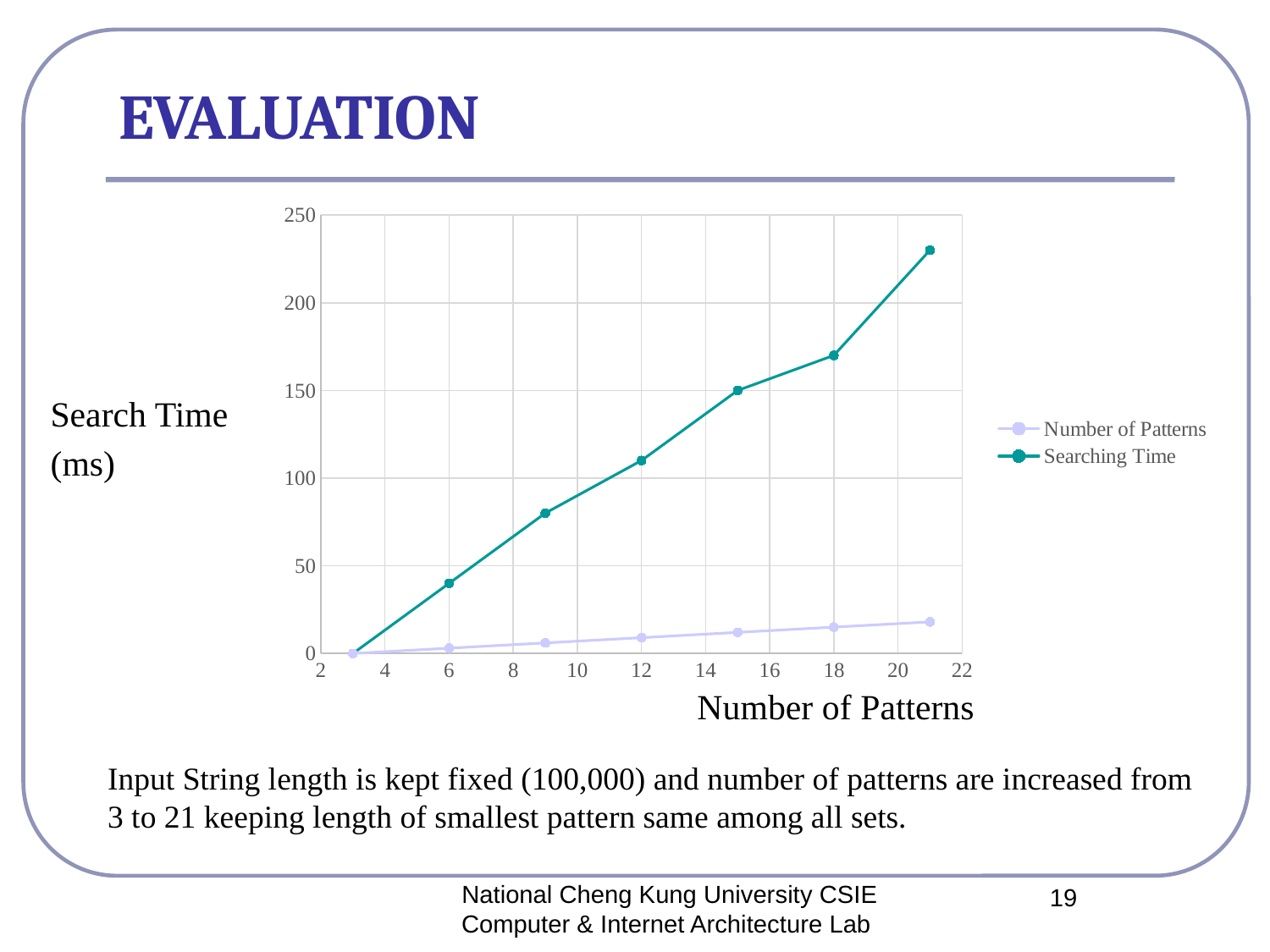
At which number of patterns is the Searching Time lowest? 3 Is the Searching Time at 12 patterns greater or less than 100? greater Is the Searching Time at 6 patterns greater or less than 50? less What is the label of the x axis? Number of Patterns What kind of chart is shown on the slide? line chart At which number of patterns is the Searching Time highest? 21 What are the two series named in the legend? Number of Patterns and Searching Time How many series does the legend list? 2 At 18 patterns, which series has the larger value, Searching Time or Number of Patterns? Searching Time Is the Searching Time at 21 patterns greater or less than 200? greater Does the Searching Time series rise or fall as the number of patterns increases? rises How many data points are plotted for the Searching Time series? 7